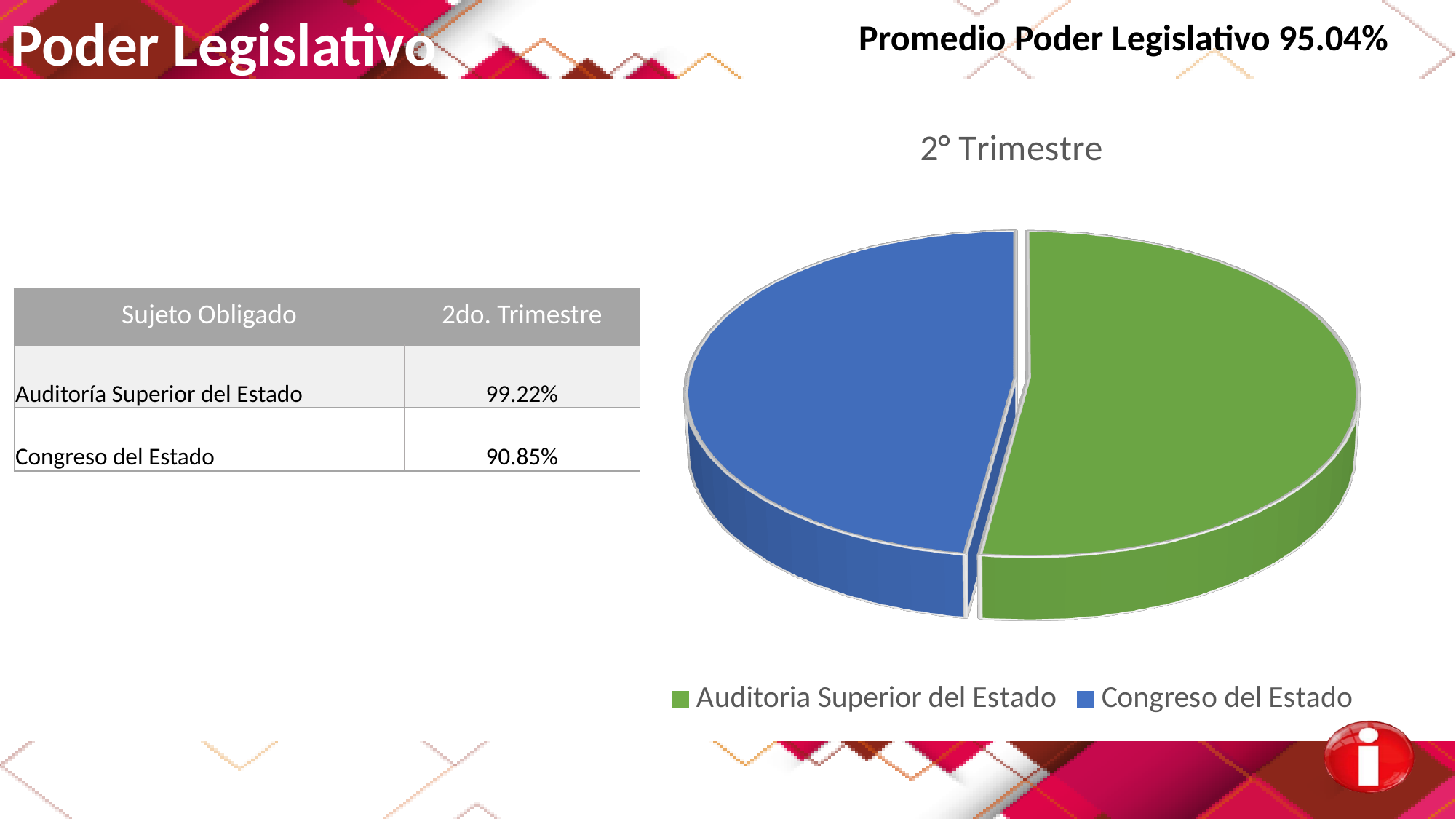
How many entries does the legend of the pie chart list? 2 What is the difference between the values for Auditoría Superior del Estado and Congreso del Estado? 8.37% Which category has the higher value, Auditoría Superior del Estado or Congreso del Estado? Auditoría Superior del Estado According to the table on the slide, what is the 2do. Trimestre value for Auditoría Superior del Estado? 99.22% Which colour represents Congreso del Estado in the pie chart? blue What is the Promedio Poder Legislativo shown on the slide? 95.04% How many slices does the pie chart have? 2 According to the table on the slide, what is the 2do. Trimestre value for Congreso del Estado? 90.85% Which category has the lowest value in the 2do. Trimestre? Congreso del Estado What kind of chart is shown on the slide? pie chart What is the title of the pie chart? 2° Trimestre